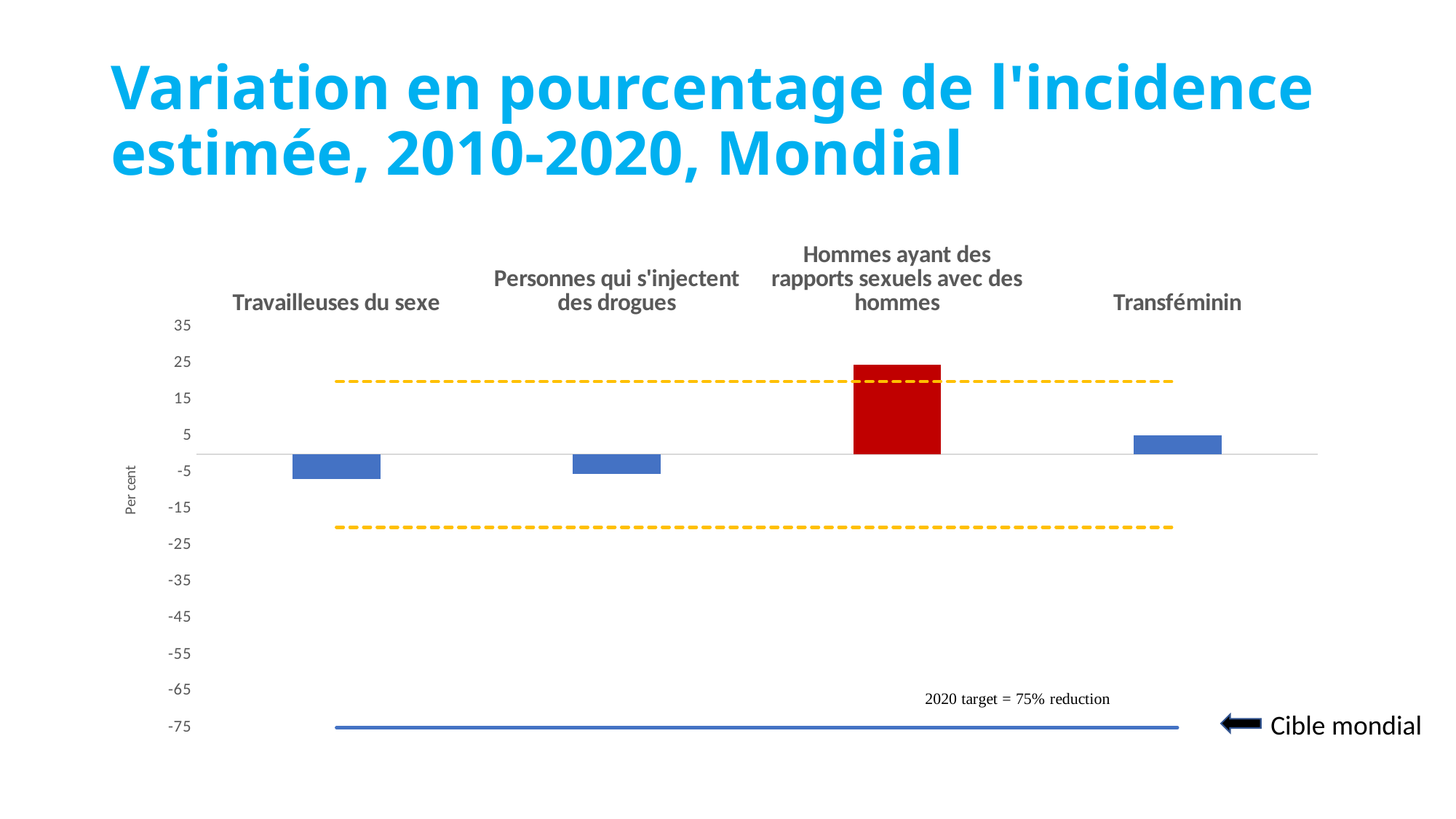
Which category has the highest value on the chart? Hommes ayant des rapports sexuels avec des hommes What is the title of the slide? Variation en pourcentage de l'incidence estimée, 2010-2020, Mondial Is the value for Travailleuses du sexe greater or less than 5? less Which is larger, the value for Travailleuses du sexe or the value for Hommes ayant des rapports sexuels avec des hommes? Hommes ayant des rapports sexuels avec des hommes How many population categories are plotted on the chart? 4 Is the value for Hommes ayant des rapports sexuels avec des hommes greater or less than 15? greater What colour is the bar for Hommes ayant des rapports sexuels avec des hommes? red Which is larger, the value for Hommes ayant des rapports sexuels avec des hommes or the value for Transféminin? Hommes ayant des rapports sexuels avec des hommes What kind of chart is shown on the slide? bar chart What is the 2020 target indicated by the solid line at the bottom of the chart? 75% reduction Is the value for Transféminin greater or less than 15? less